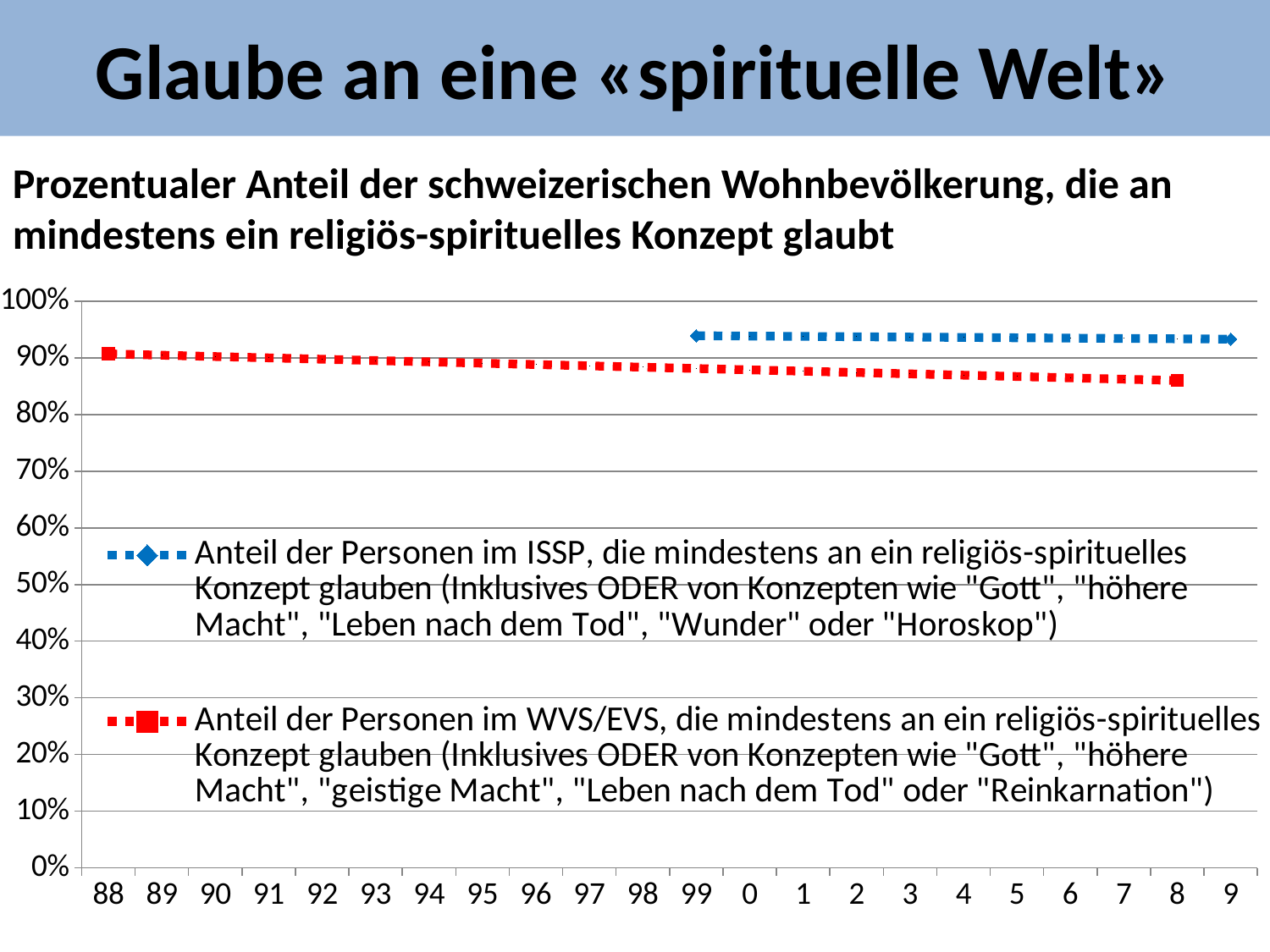
What colour is the line for the ISSP series? blue Is the value of the ISSP series (blue) at 9 greater or less than 100%? less Do the values of the WVS/EVS series (red) rise or fall from 88 to 8 along the x axis? fall Is the value of the WVS/EVS series (red) at 8 greater or less than 90%? less What kind of chart is shown on the slide? line chart How many year labels are shown along the x axis? 22 At 99 on the x axis, which series has the lower value, ISSP or WVS/EVS? WVS/EVS What is the title of the slide? Glaube an eine «spirituelle Welt» Is the value of the WVS/EVS series (red) at 88 greater or less than 80%? greater How many series does the legend list? 2 At 8 on the x axis, which series has the higher value, ISSP or WVS/EVS? ISSP